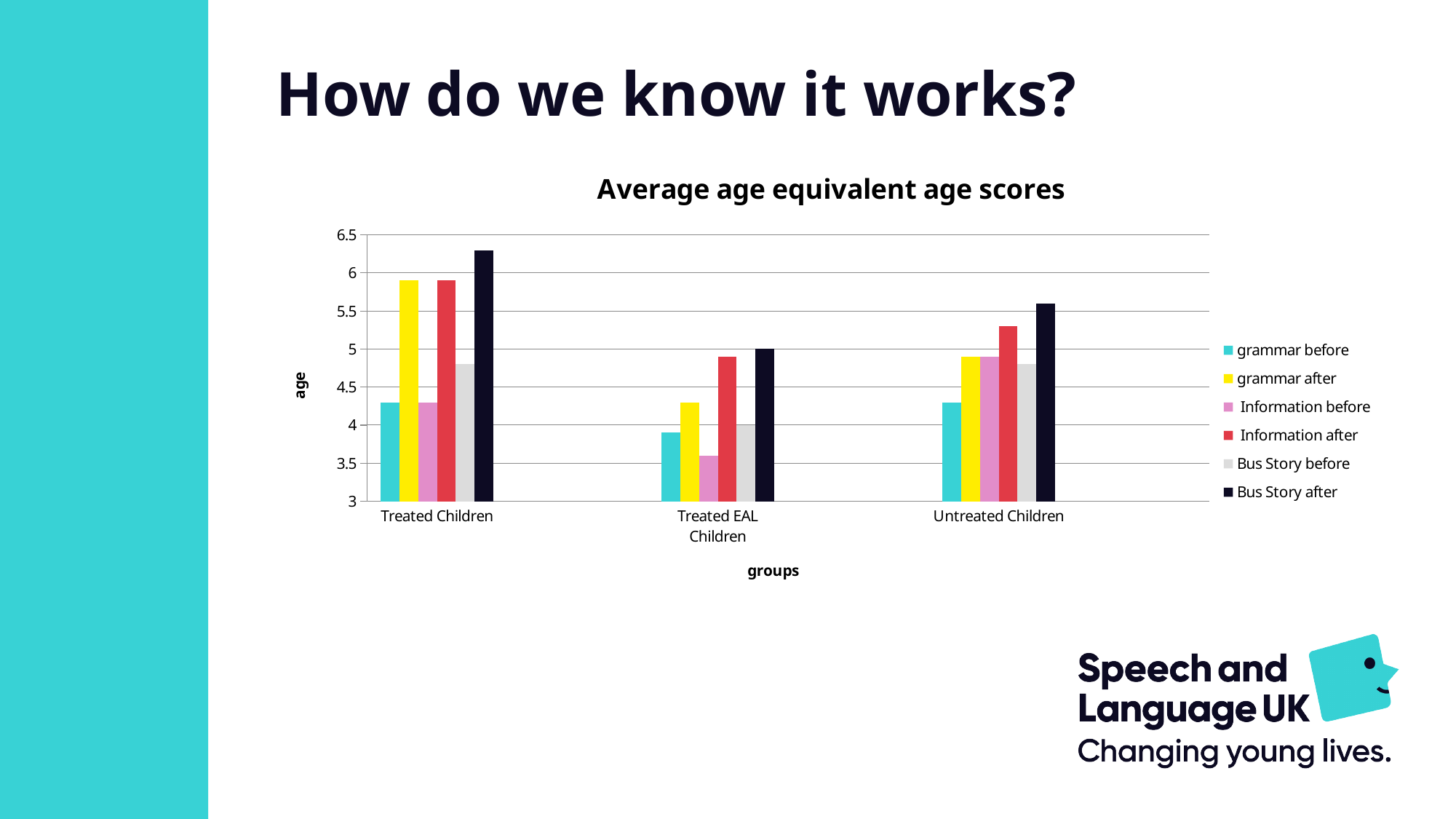
What kind of chart is shown on the slide? bar chart What is the title of the chart? Average age equivalent age scores Which is larger: the grammar after score for Treated Children or for Untreated Children? Treated Children Which group has the lowest Information before score? Treated EAL Children Is the Information after value for Untreated Children greater or less than 5? greater Which group has the highest Bus Story after score? Treated Children How many groups are shown on the x axis? 3 Is the Information before value for Treated EAL Children greater or less than 4? less How many series does the legend list? 6 What is the label of the vertical axis? age Is the Bus Story after value for Treated Children greater or less than 6? greater